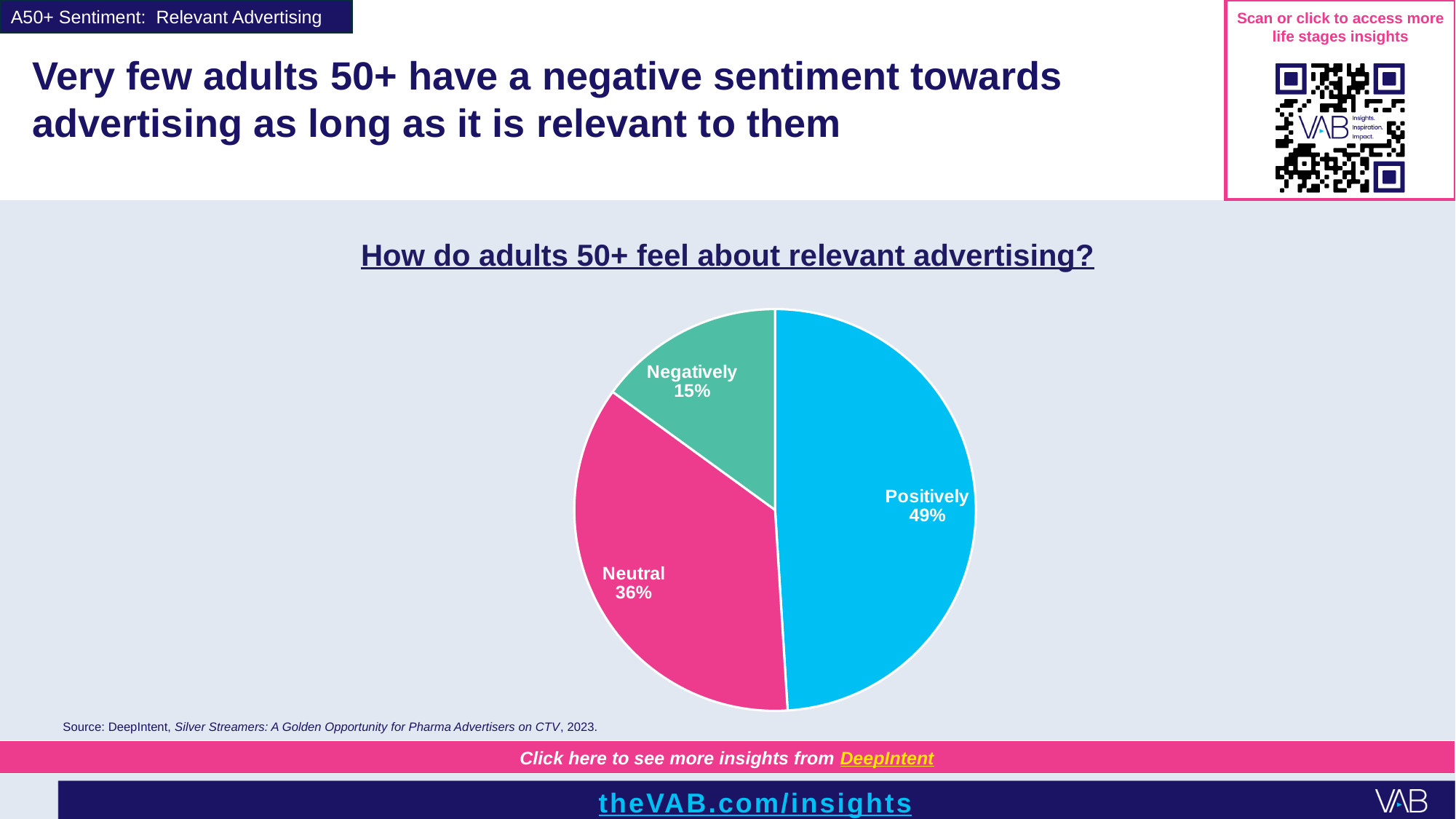
What percentage of adults 50+ feel neutral about relevant advertising? 36% What is the difference in percentage points between the Positively and Negatively slices? 34 Which sentiment has the smallest share of the pie? Negatively What kind of chart is shown on the slide? Pie chart Which is larger, the Neutral slice or the Negatively slice? Neutral What is the title of the chart? How do adults 50+ feel about relevant advertising? Which sentiment has the largest share of the pie? Positively What colour is the Positively slice of the pie? Blue What percentage of adults 50+ feel positively about relevant advertising? 49% How many slices does the pie chart have? 3 What is the difference in percentage points between the Neutral and Negatively slices? 21 What percentage of adults 50+ feel negatively about relevant advertising? 15%